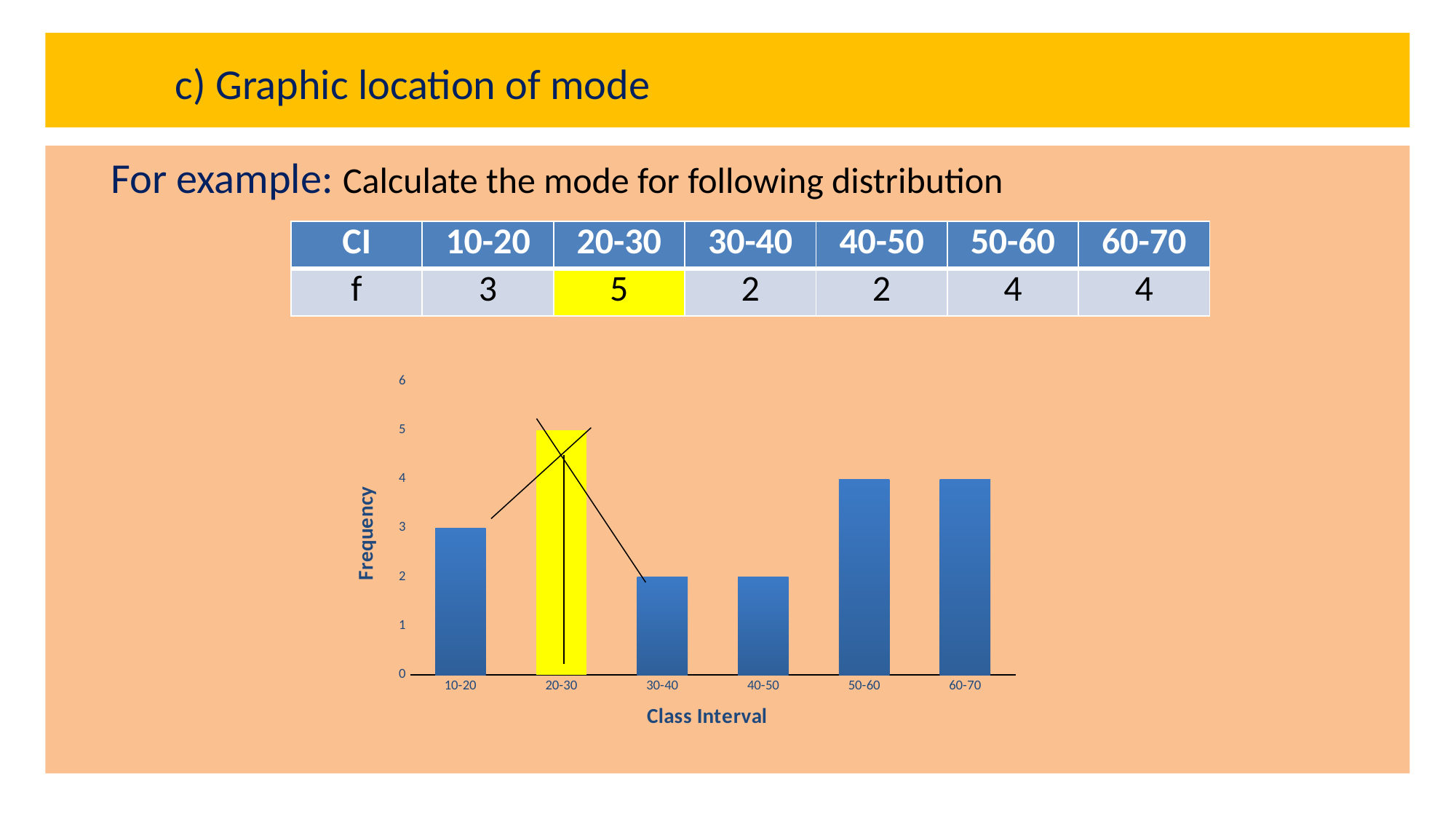
How many class intervals are plotted on the x axis of the chart? 6 Which has a higher frequency, the 10-20 class interval or the 60-70 class interval? 60-70 Which bar in the chart is coloured yellow? 20-30 What is the label of the y axis of the chart? Frequency What is the frequency for the class interval 50-60? 4 What kind of chart is shown on the slide? bar chart What is the frequency for the class interval 10-20? 3 Which class interval has the highest frequency? 20-30 Is the frequency for the 40-50 class interval greater or less than 3? less What is the label of the x axis of the chart? Class Interval What is the difference in frequency between the 20-30 and 30-40 class intervals? 3 What is the frequency for the class interval 20-30? 5